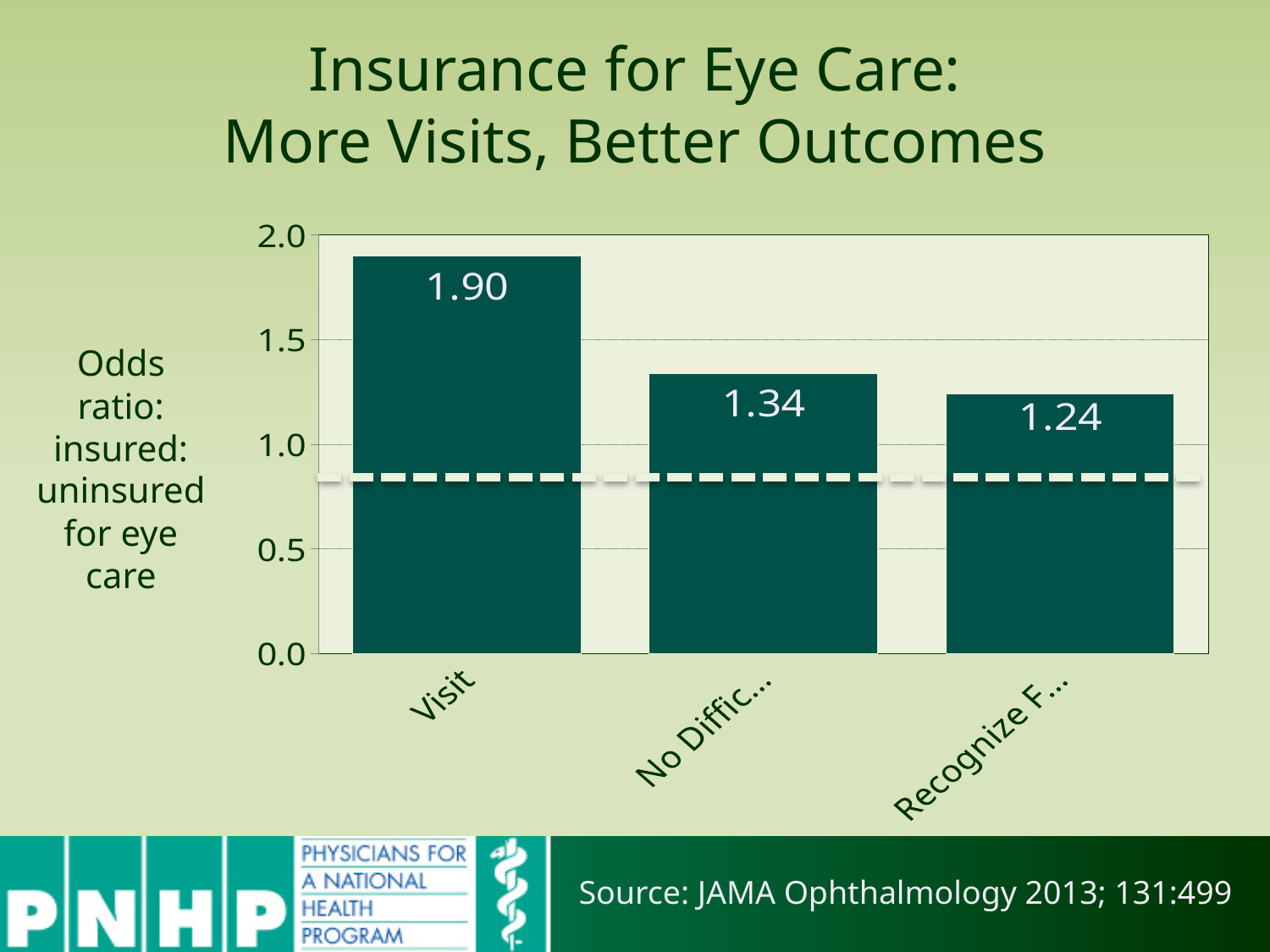
How many bars are plotted in the chart? 3 Which bar has the lowest value? The rightmost bar (Recognize F...) What is the difference between the Visit value and the value of the rightmost bar? 0.66 Is the value for Visit greater or less than 1.5? greater What is the difference between the Visit value and the second bar's value? 0.56 Which category has the highest odds ratio? Visit What value is printed on the second bar from the left (labelled "No Diffic...")? 1.34 What value is printed on the rightmost bar (labelled "Recognize F...")? 1.24 Do the bar values rise or fall from left to right? Fall Which is larger, the value for Visit or the value for the second bar? Visit What kind of chart is shown on the slide? Bar chart What is the odds ratio value shown for the Visit bar? 1.90